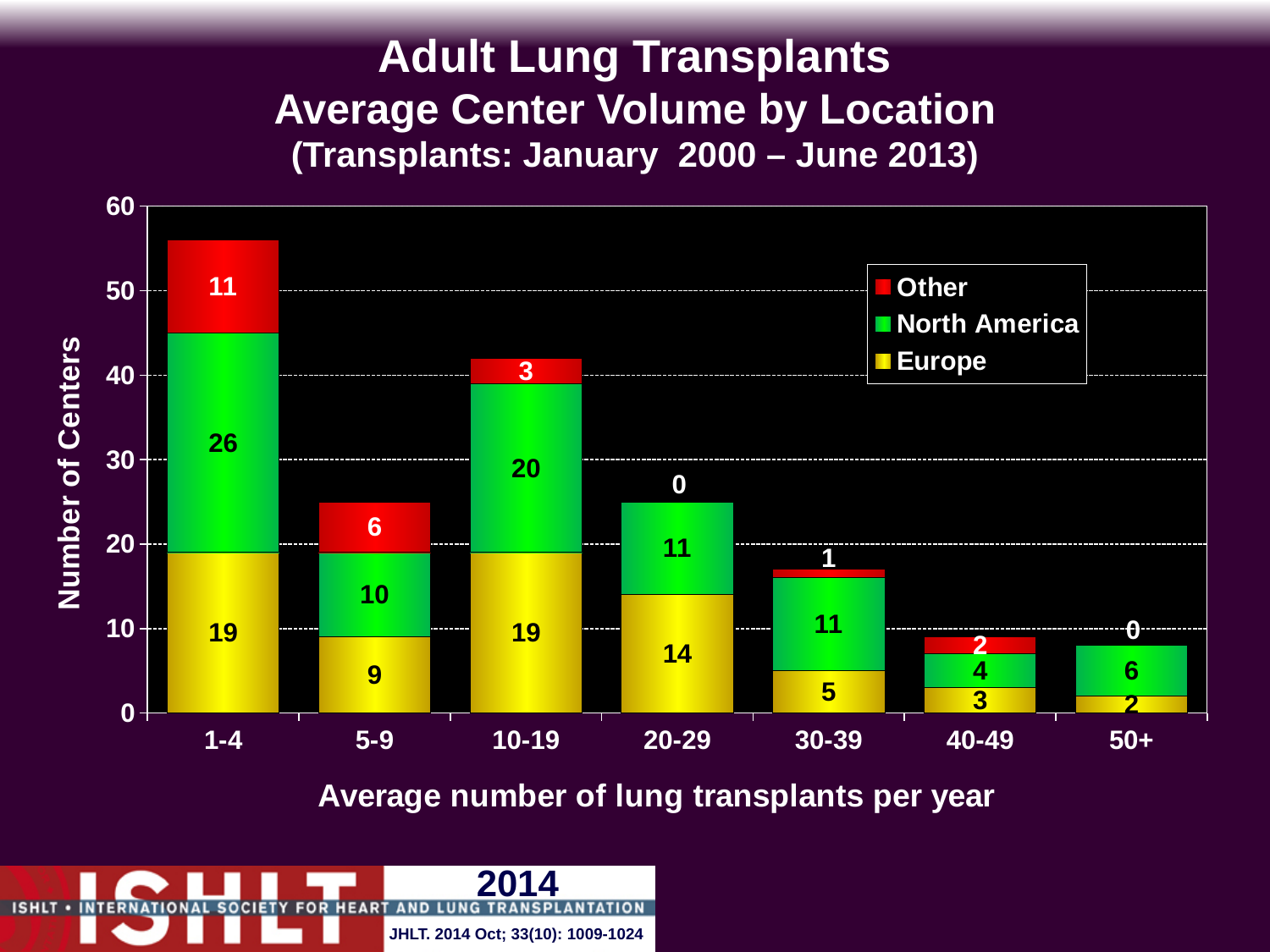
Which category has the lowest number of Europe centers? 50+ What is the number of Other centers in the 5-9 category? 6 Which category has the highest number of North America centers? 1-4 What is the number of Europe centers in the 1-4 category? 19 Which is larger in the 50+ category, North America or Europe? North America How many categories are shown on the x axis? 7 What is the number of North America centers in the 10-19 category? 20 How many series does the legend list? 3 What is the total number of centers in the 30-39 category? 17 What type of chart is shown on the slide? Stacked bar chart What is the total number of centers in the 1-4 category? 56 What is the difference between the North America and Europe values in the 20-29 category? 3